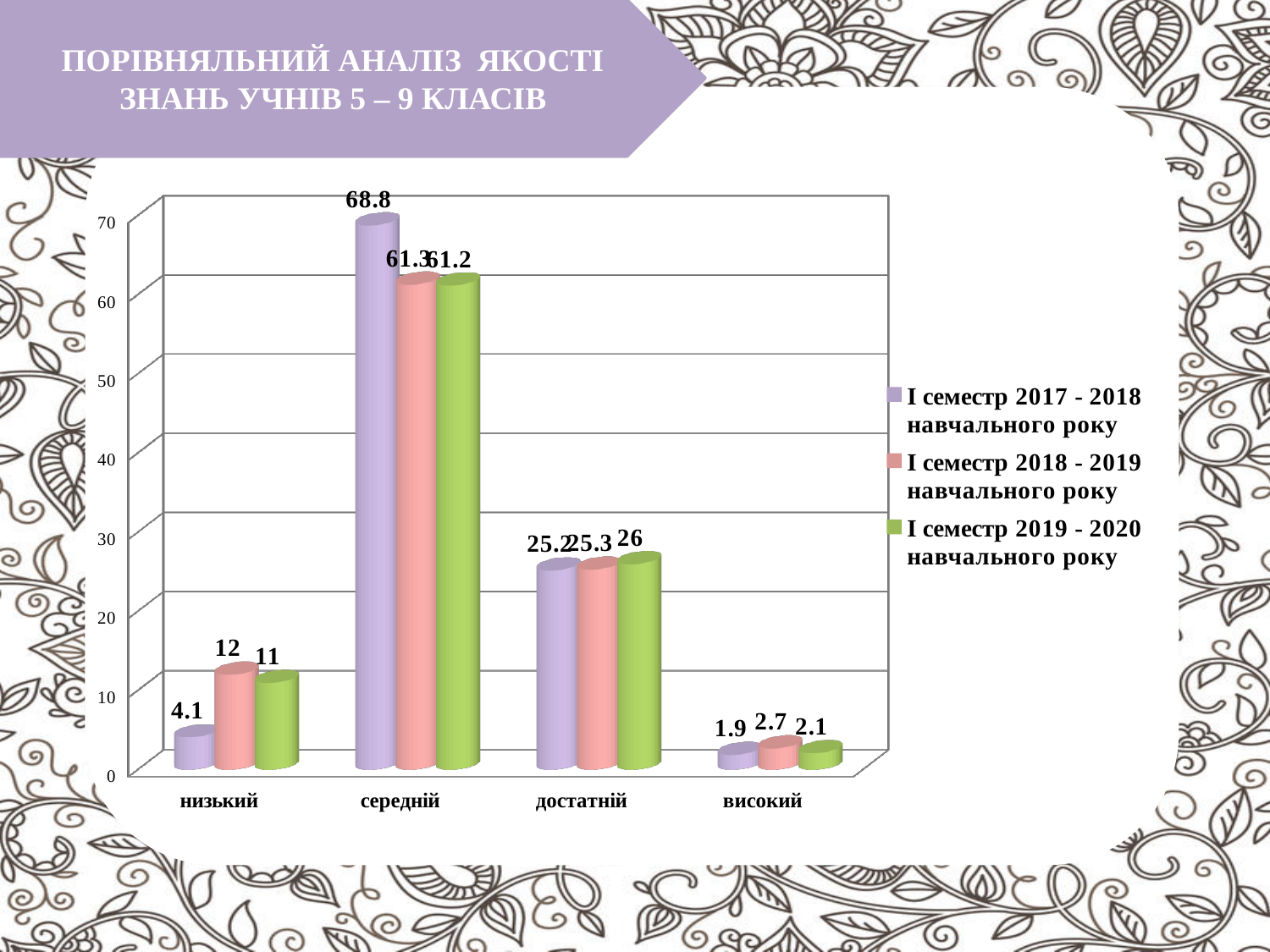
Is the value for середній in the І семестр 2018 - 2019 навчального року series greater or less than 60? greater What is the value for середній in the І семестр 2017 - 2018 навчального року series? 68.8 What kind of chart is shown on the slide? bar chart How many categories are shown on the x axis? 4 How many series does the legend list? 3 Which category has the lowest value in the І семестр 2017 - 2018 навчального року series? високий What is the value for високий in the І семестр 2018 - 2019 навчального року series? 2.7 For середній, which is larger: the І семестр 2017 - 2018 value or the І семестр 2018 - 2019 value? І семестр 2017 - 2018 навчального року What is the value for низький in the І семестр 2017 - 2018 навчального року series? 4.1 What is the value for достатній in the І семестр 2019 - 2020 навчального року series? 26 What is the difference between the низький values for І семестр 2018 - 2019 and І семестр 2017 - 2018 навчального року? 7.9 Which category has the highest value in the І семестр 2019 - 2020 навчального року series? середній